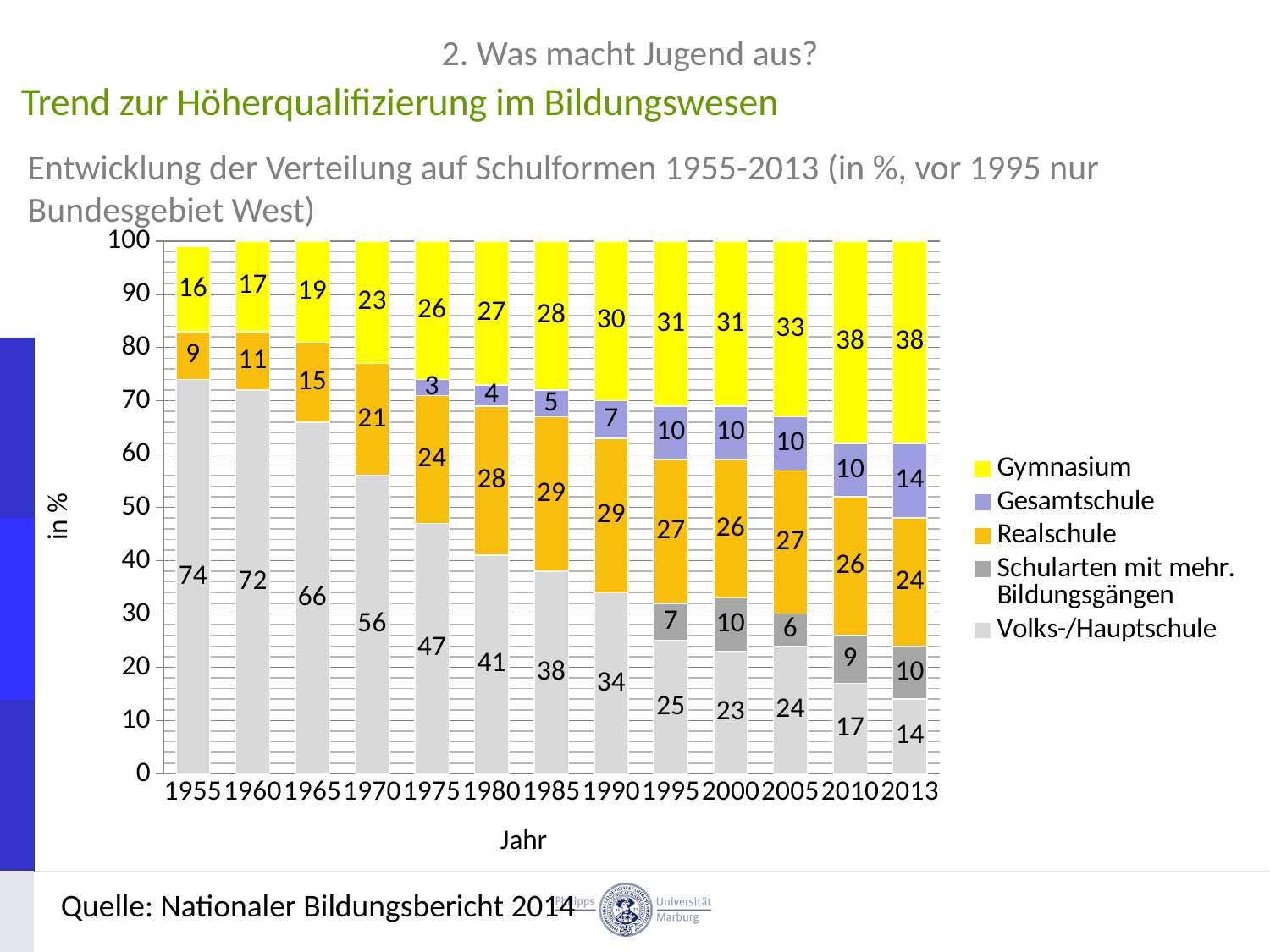
What is the value for Gesamtschule in 1975? 3 What is the value for Realschule in 1985? 29 What is the value for Gymnasium in 2013? 38 What is the difference between the Volks-/Hauptschule value in 1955 and in 2013? 60 In which year is the Gymnasium value highest? 2010 and 2013 What is the value for Volks-/Hauptschule in 1955? 74 What kind of chart is shown on the slide? stacked bar chart How many series does the legend list? 5 Does the Volks-/Hauptschule value rise or fall from 1955 to 1990? fall How many years are shown on the x axis? 13 Which is larger in 1995: the Realschule value or the Gymnasium value? Gymnasium In which year is the Volks-/Hauptschule value lowest? 2013